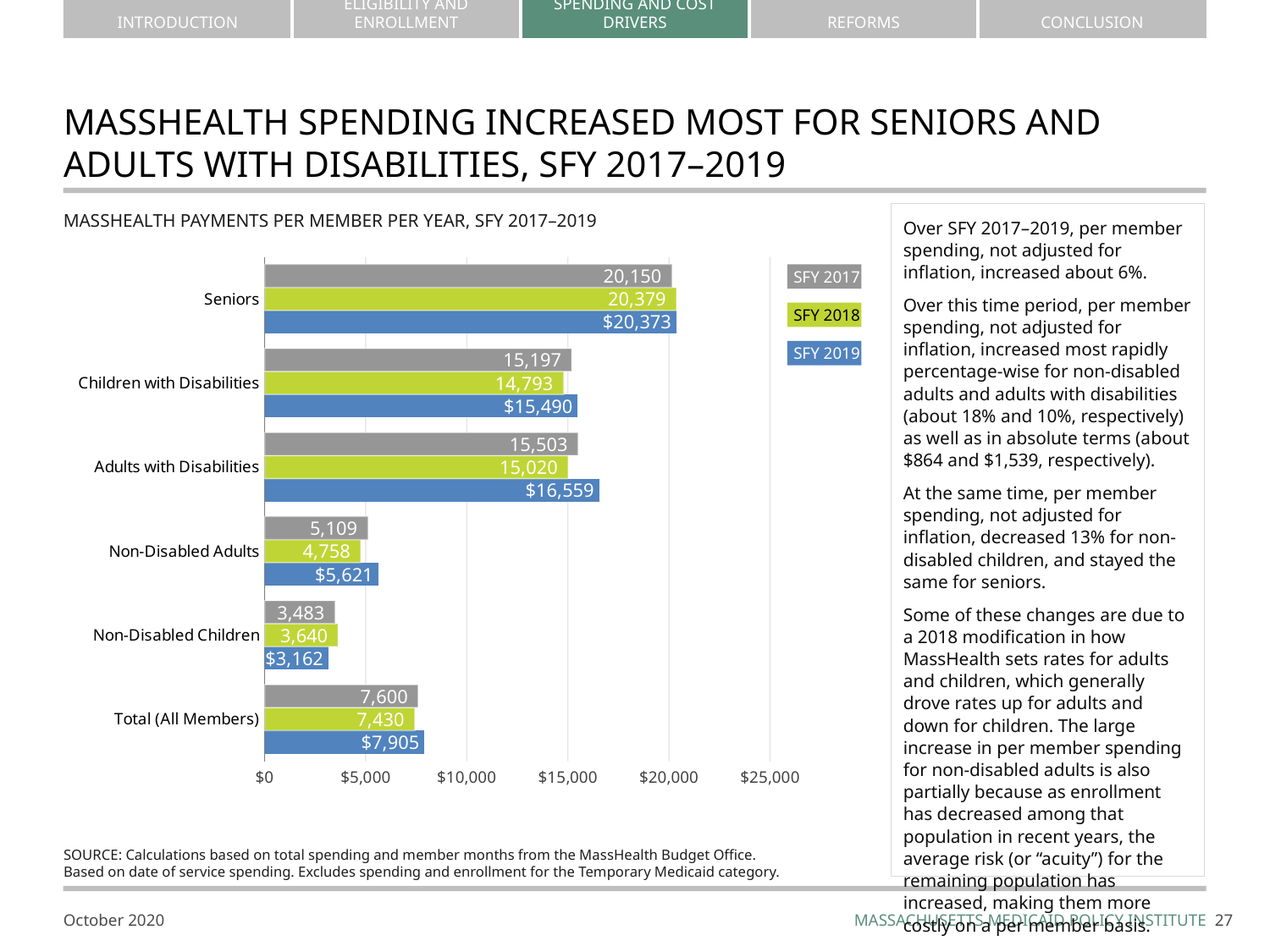
What is the difference between the SFY 2019 and SFY 2017 values for Non-Disabled Adults? 512 What kind of chart is shown on the slide? Bar chart What is the SFY 2018 value for Non-Disabled Children? 3,640 What is the SFY 2019 value for Total (All Members)? $7,905 What is the SFY 2017 value for Seniors? 20,150 How many categories are shown on the chart? 6 What is the SFY 2019 value for Adults with Disabilities? $16,559 How many series does the legend list? 3 Which category has the lowest SFY 2017 value? Non-Disabled Children What colour are the SFY 2019 bars? Blue Which category has the highest SFY 2019 value? Seniors Which is larger for Children with Disabilities: the SFY 2017 value or the SFY 2018 value? SFY 2017